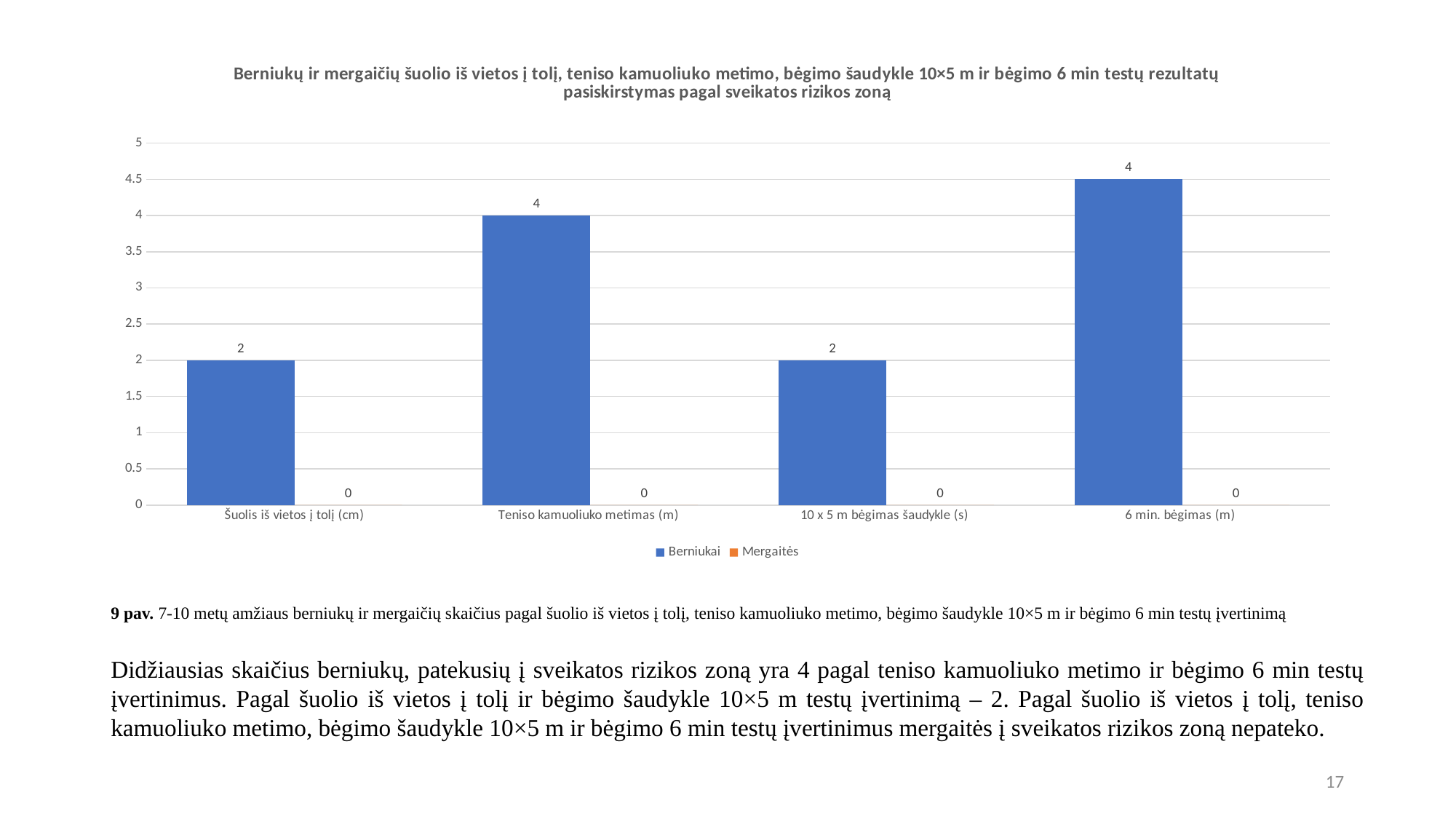
What is the difference between the Berniukai values for Teniso kamuoliuko metimas (m) and Šuolis iš vietos į tolį (cm)? 2 How many series does the legend list? 2 For Berniukai, which is larger: Teniso kamuoliuko metimas (m) or 10 x 5 m bėgimas šaudykle (s)? Teniso kamuoliuko metimas (m) Is the Berniukai value for Teniso kamuoliuko metimas (m) greater or less than 3? greater What is the value for Berniukai in the 10 x 5 m bėgimas šaudykle (s) category? 2 What is the value for Berniukai in the Šuolis iš vietos į tolį (cm) category? 2 What is the value for Berniukai in the Teniso kamuoliuko metimas (m) category? 4 What are the two series names listed in the legend? Berniukai and Mergaitės Is the Berniukai value for Šuolis iš vietos į tolį (cm) greater or less than 3? less What kind of chart is shown on the slide? bar chart What is the value for Mergaitės in the Teniso kamuoliuko metimas (m) category? 0 How many categories are shown on the x axis of the chart? 4